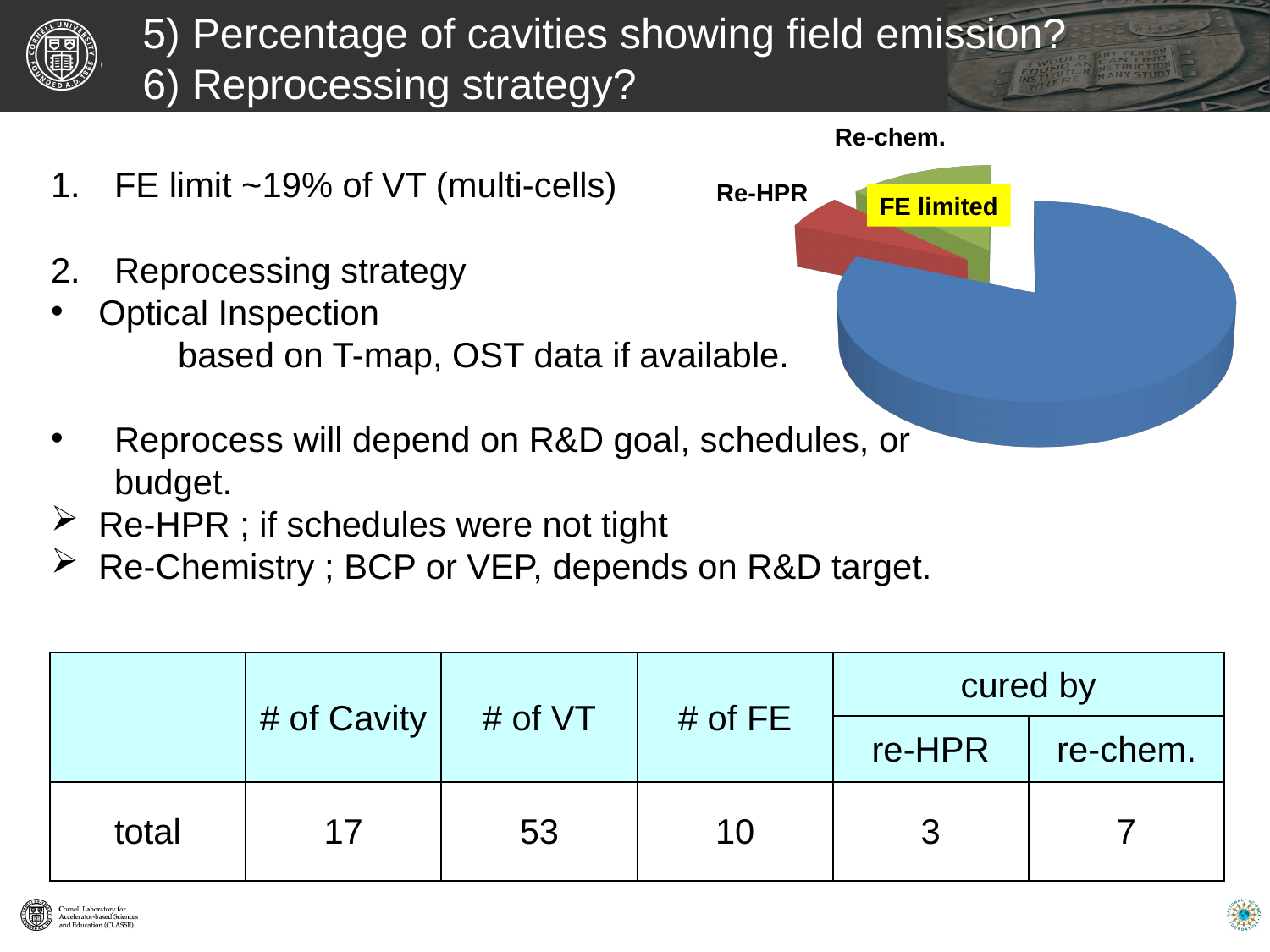
How many slices does the pie chart have? 3 What colour is the Re-chem. slice in the pie chart? green Which slice of the pie chart is the largest? the blue slice Which labelled slice of the pie chart is the smallest? Re-HPR What colour is the Re-HPR slice in the pie chart? red Which slice is larger in the pie chart, Re-HPR or Re-chem.? Re-chem. What kind of chart is shown on the slide? pie chart